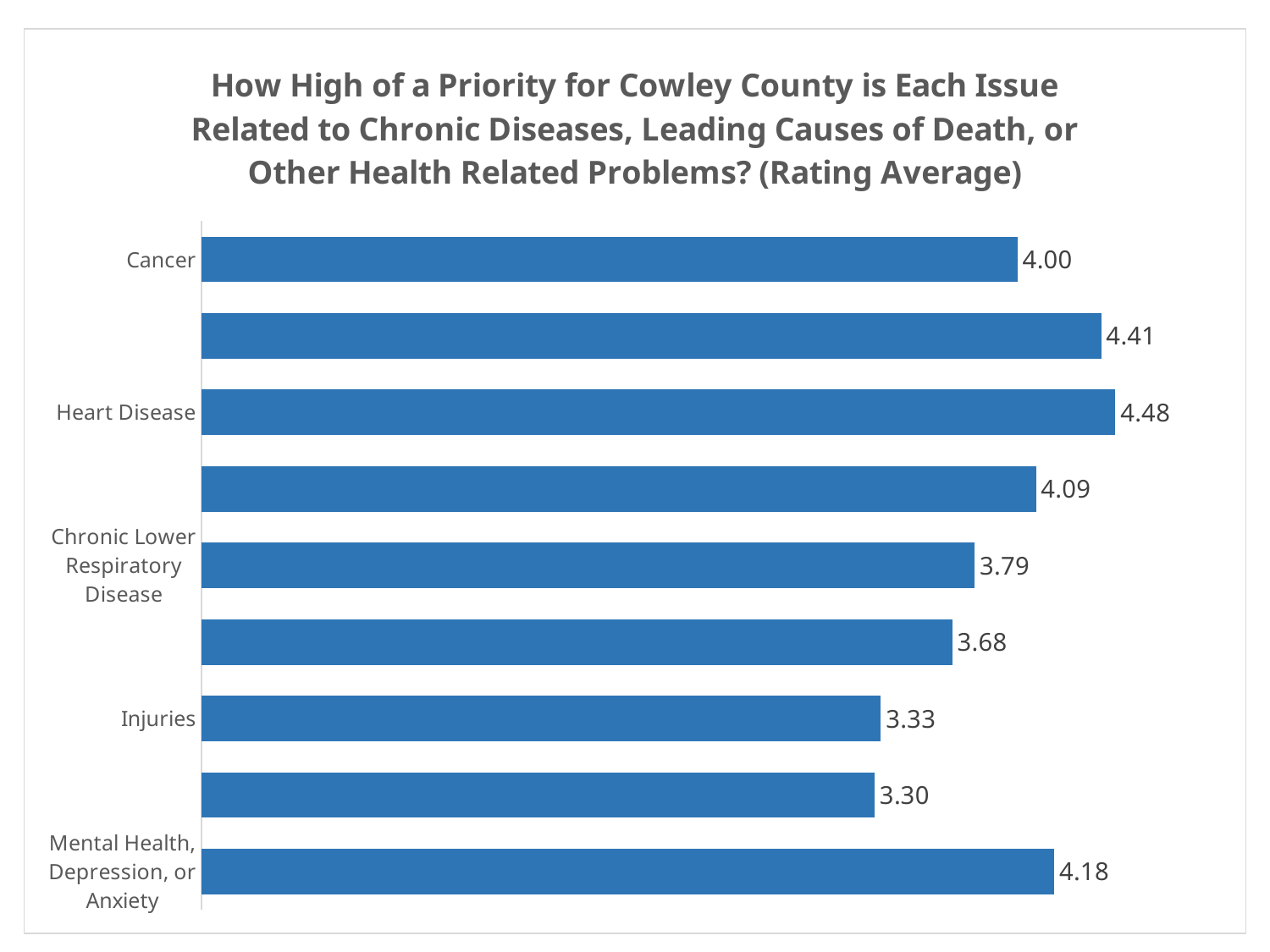
Which has a higher rating average, Cancer or Mental Health, Depression, or Anxiety? Mental Health, Depression, or Anxiety What is the rating average for Mental Health, Depression, or Anxiety? 4.18 What is the rating average for Heart Disease? 4.48 What is the rating average for Cancer? 4.00 What is the difference between the rating averages for Mental Health, Depression, or Anxiety and Injuries? 0.85 What is the lowest rating average shown on the chart? 3.30 What kind of chart is shown on the slide? Bar chart What is the rating average for Chronic Lower Respiratory Disease? 3.79 What is the difference between the rating averages for Heart Disease and Cancer? 0.48 What is the rating average for Injuries? 3.33 How many bars are plotted on the chart? 9 Which labeled issue has the highest rating average? Heart Disease